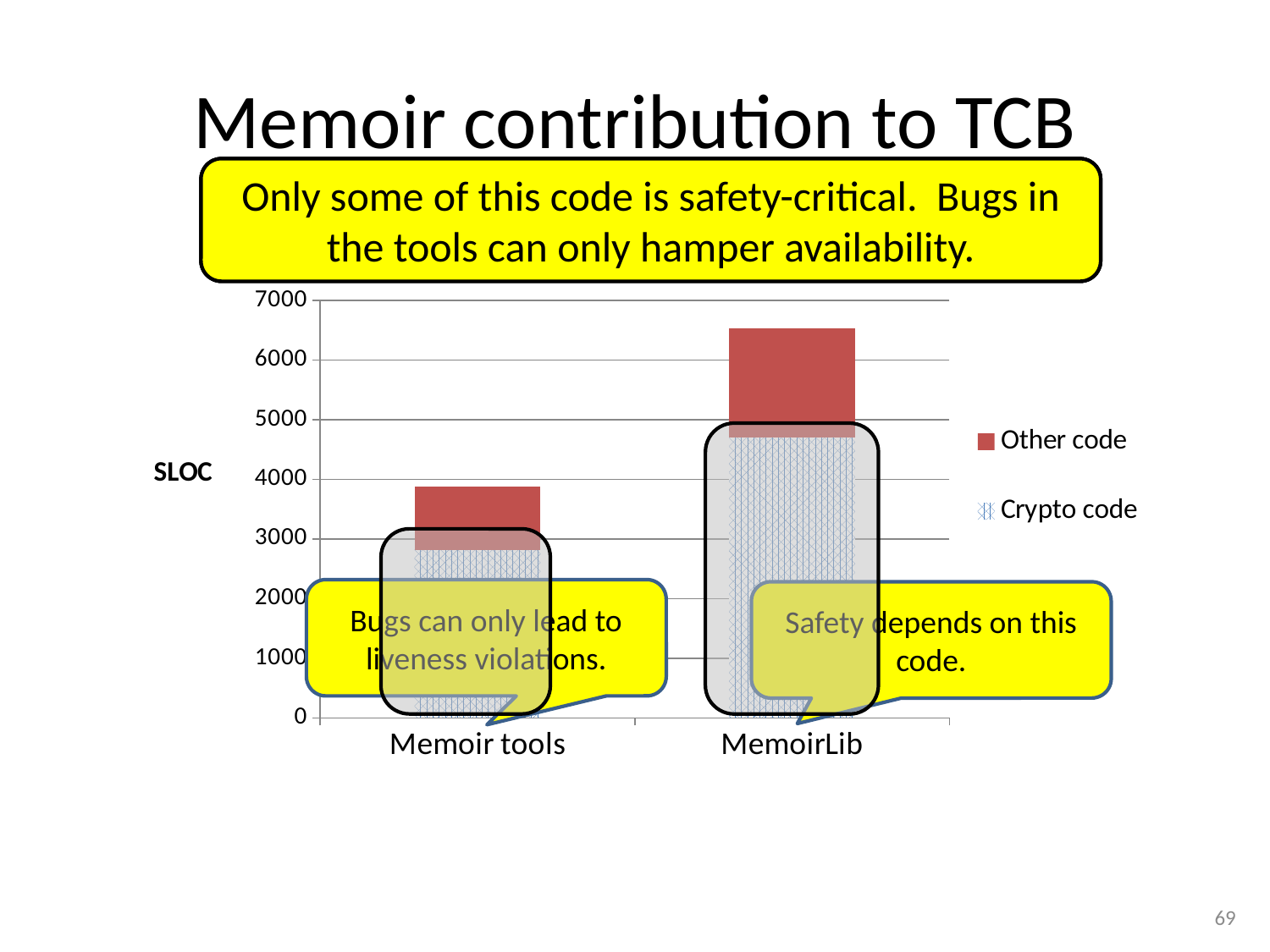
Is the total SLOC for MemoirLib greater or less than 6000? greater Which category has the taller stacked bar, Memoir tools or MemoirLib? MemoirLib What kind of chart is shown on the slide? stacked bar chart How many series does the chart's legend list? 2 Which category has the shorter stacked bar? Memoir tools Is the total SLOC for Memoir tools greater or less than 4000? less What are the two series named in the chart's legend? Other code and Crypto code Is the Crypto code value for Memoir tools greater or less than 3000? less How many categories are shown on the x axis of the chart? 2 Which category has more Crypto code, Memoir tools or MemoirLib? MemoirLib What is the label on the vertical axis of the chart? SLOC